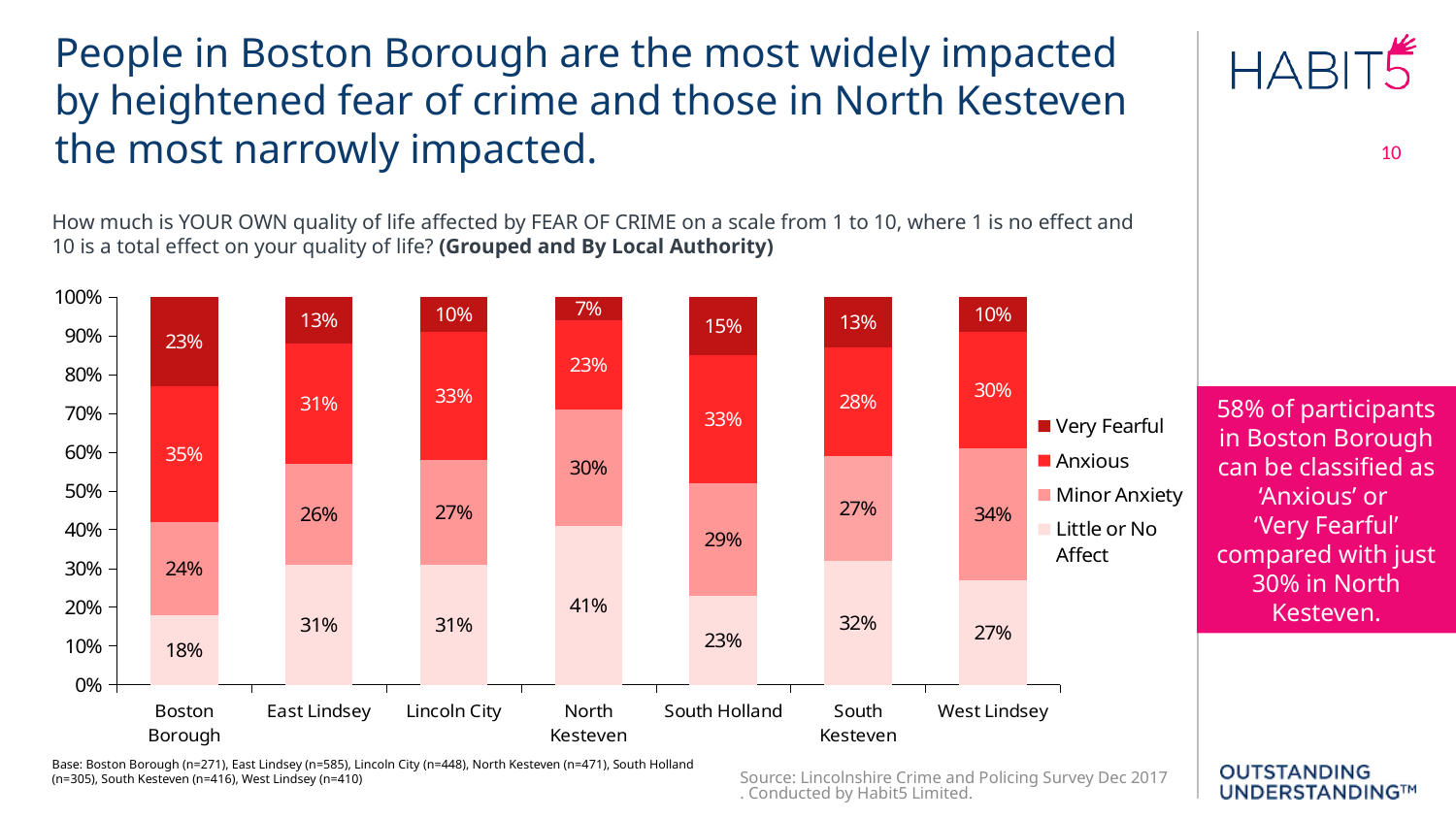
What is the 'Minor Anxiety' value for West Lindsey? 34% Which is larger: the 'Little or No Affect' share in South Kesteven or in South Holland? South Kesteven What percentage of North Kesteven participants report 'Little or No Affect'? 41% How many local authorities are shown on the x axis of the chart? 7 What type of chart is shown on the slide? Stacked bar chart What is the difference between the 'Anxious' percentage in Boston Borough and in North Kesteven? 12 percentage points Which local authority has the lowest 'Little or No Affect' percentage? Boston Borough Which local authority has the lowest 'Very Fearful' percentage? North Kesteven What percentage of Boston Borough participants are classified as 'Very Fearful'? 23% Which local authority has the highest 'Very Fearful' percentage? Boston Borough How many series does the chart legend list? 4 What is the combined percentage of 'Anxious' and 'Very Fearful' participants in Boston Borough? 58%